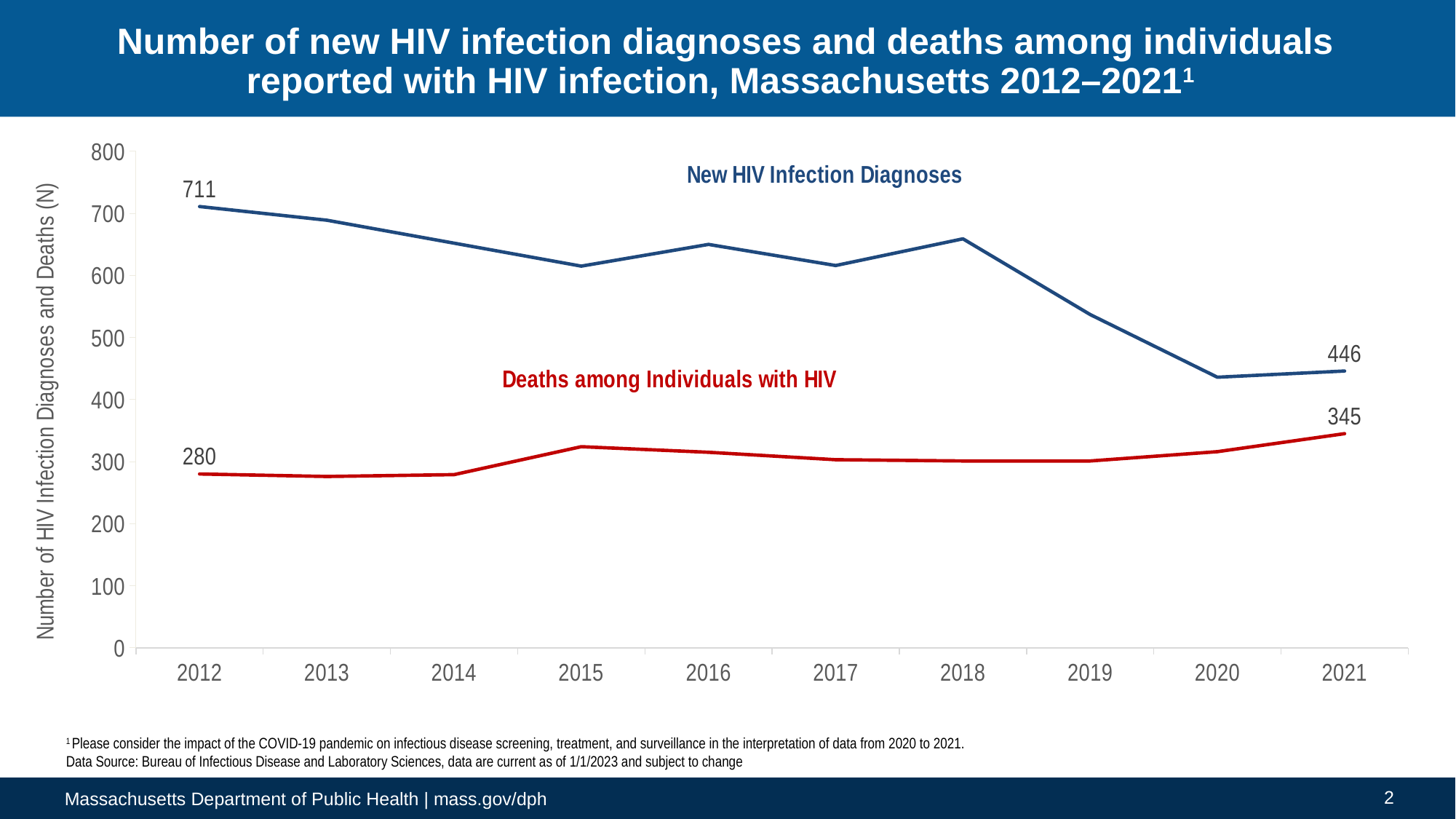
What was the number of new HIV infection diagnoses in 2021? 446 Is the number of deaths among individuals with HIV in 2015 greater or less than 400? less What type of chart is shown on the slide? Line chart What was the number of new HIV infection diagnoses in 2012? 711 What was the number of deaths among individuals with HIV in 2012? 280 Is the number of new HIV infection diagnoses in 2018 greater or less than 600? greater What was the number of deaths among individuals with HIV in 2021? 345 By how much did new HIV infection diagnoses decrease from 2012 to 2021? 265 By how much did deaths among individuals with HIV increase from 2012 to 2021? 65 In which year were new HIV infection diagnoses lowest? 2020 In which year were new HIV infection diagnoses highest? 2012 How many years are shown on the x axis? 10